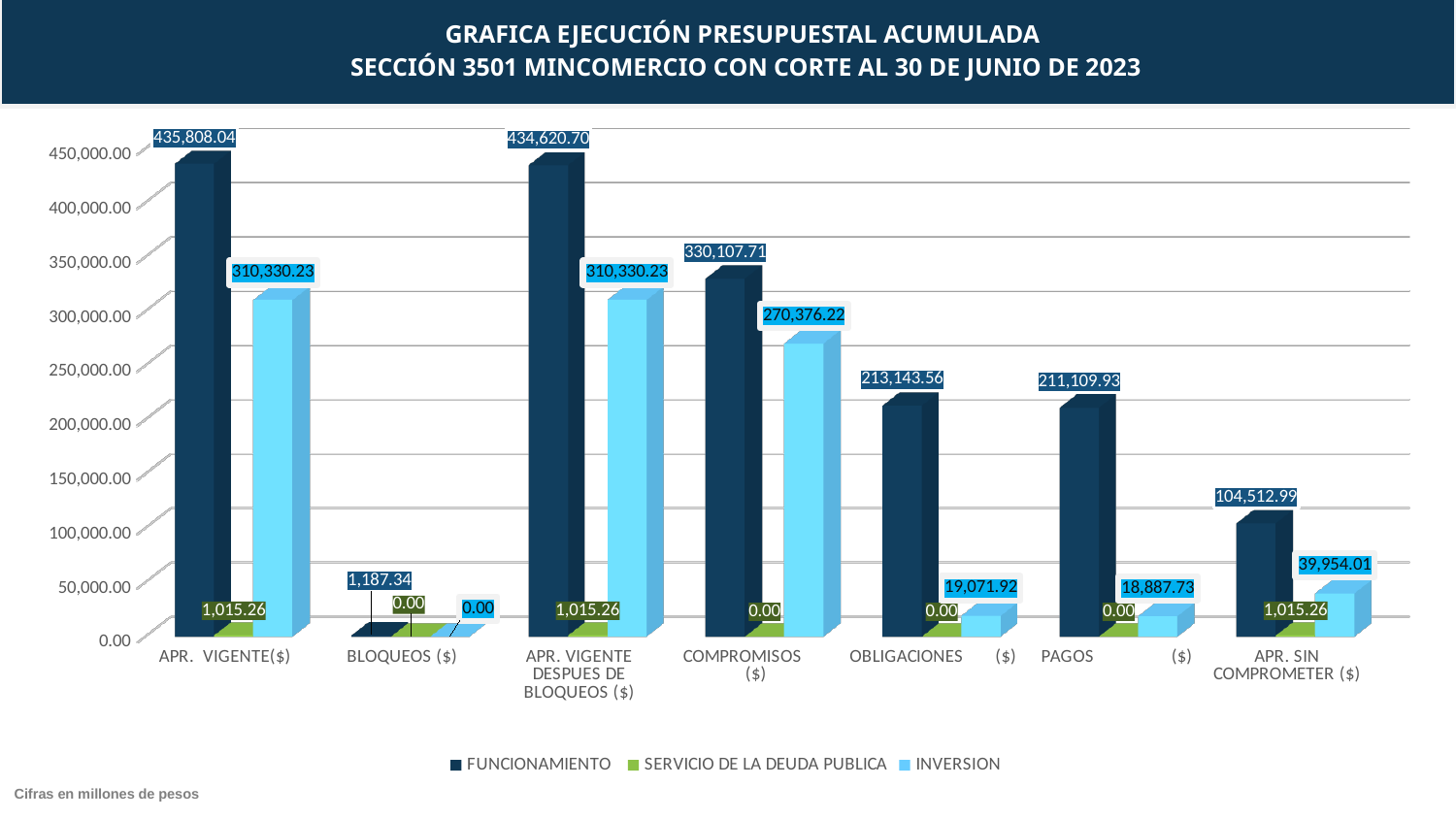
Which category has the highest INVERSION value? APR. VIGENTE($) and APR. VIGENTE DESPUES DE BLOQUEOS ($) (both 310,330.23) How many categories are shown on the x axis? 7 Which is larger for OBLIGACIONES ($): the FUNCIONAMIENTO value or the INVERSION value? FUNCIONAMIENTO What kind of chart is shown on the slide? Bar chart What is the SERVICIO DE LA DEUDA PUBLICA value for APR. SIN COMPROMETER ($)? 1,015.26 What is the FUNCIONAMIENTO value for APR. VIGENTE($)? 435,808.04 What is the INVERSION value for COMPROMISOS ($)? 270,376.22 What is the difference between the FUNCIONAMIENTO values for APR. VIGENTE($) and APR. VIGENTE DESPUES DE BLOQUEOS ($)? 1,187.34 What is the FUNCIONAMIENTO value for BLOQUEOS ($)? 1,187.34 How many series does the legend list? 3 What is the difference between the FUNCIONAMIENTO and INVERSION values for COMPROMISOS ($)? 59,731.49 Which category has the lowest FUNCIONAMIENTO value? BLOQUEOS ($)